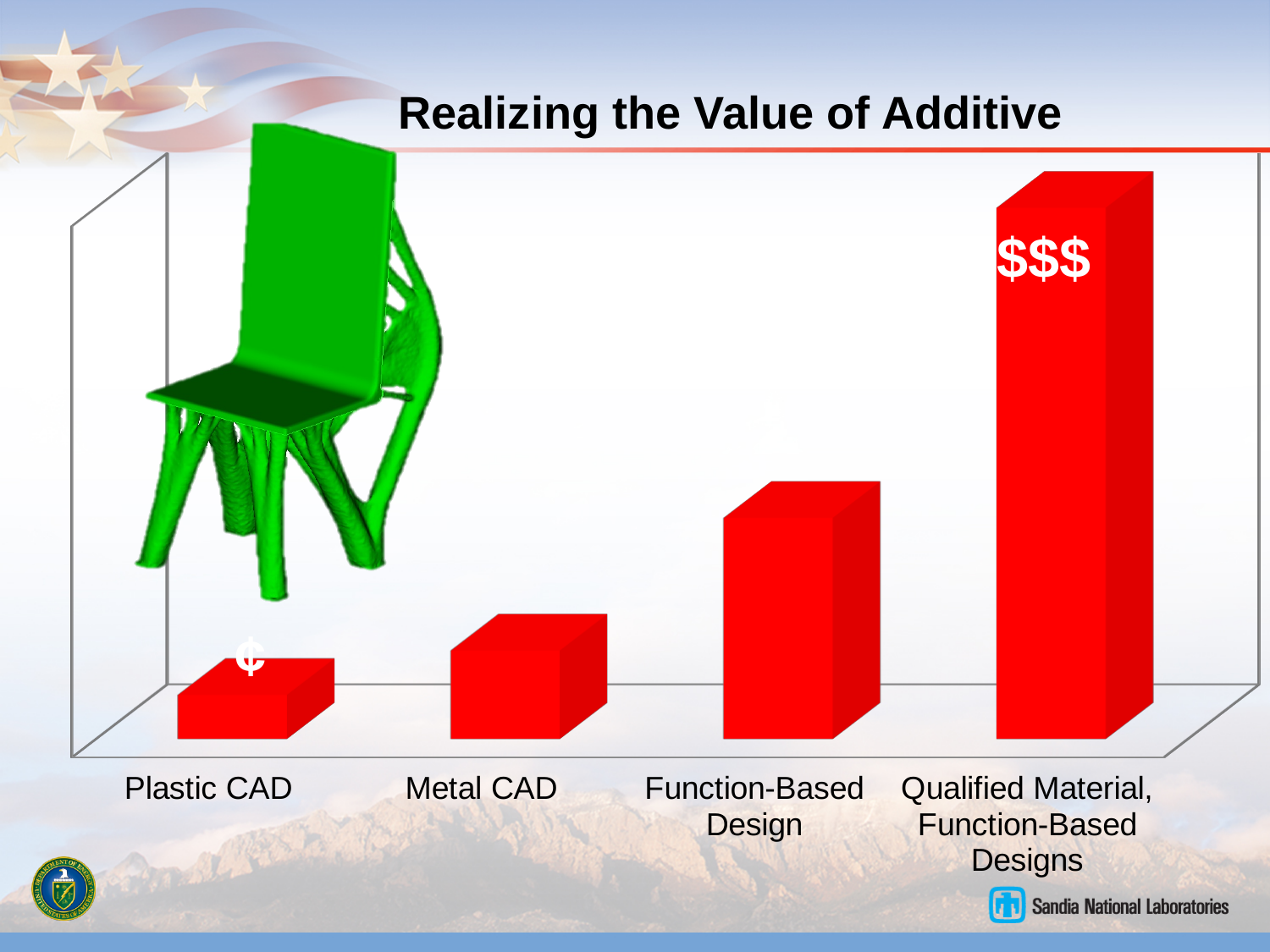
How many categories are shown along the x axis of the chart? 4 What symbol is printed on the tallest bar of the chart? $$$ Which bar is taller, Metal CAD or Function-Based Design? Function-Based Design What kind of chart is shown on the slide? Bar chart Which category has the tallest bar? Qualified Material, Function-Based Designs What is the title of the chart on the slide? Realizing the Value of Additive Which bar is taller, Plastic CAD or Metal CAD? Metal CAD Do the bar heights rise or fall from left to right across the categories? Rise Which category has the shortest bar? Plastic CAD